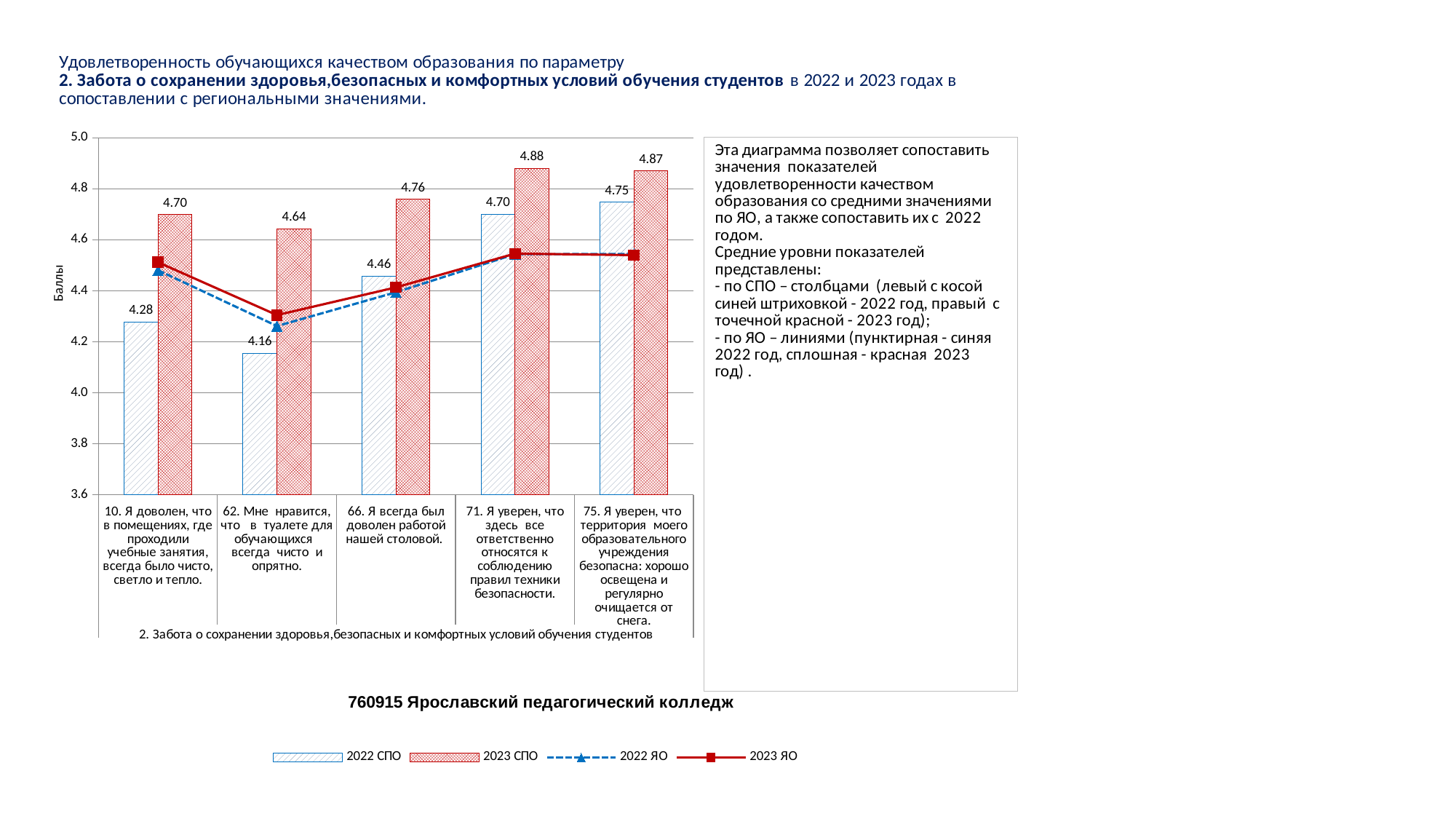
What kind of chart is shown on the slide? Combined bar and line chart What is the 2022 СПО value for category "10. Я доволен, что в помещениях, где проходили учебные занятия, всегда было чисто, светло и тепло."? 4.28 What is the difference between the 2023 СПО and 2022 СПО values for category "62. Мне нравится, что в туалете для обучающихся всегда чисто и опрятно."? 0.48 Which is larger for category "75. Я уверен, что территория моего образовательного учреждения безопасна...": the 2022 СПО value or the 2023 СПО value? 2023 СПО How many categories are shown on the x axis of the chart? 5 What is the label of the vertical axis of the chart? Баллы Is the 2023 ЯО value for category "62. Мне нравится, что в туалете для обучающихся всегда чисто и опрятно." greater or less than 4.4? less What is the 2023 СПО value for category "66. Я всегда был доволен работой нашей столовой."? 4.76 Which category has the highest 2023 СПО value? 71. Я уверен, что здесь все ответственно относятся к соблюдению правил техники безопасности. What is the 2022 СПО value for category "62. Мне нравится, что в туалете для обучающихся всегда чисто и опрятно."? 4.16 Which category has the lowest 2022 СПО value? 62. Мне нравится, что в туалете для обучающихся всегда чисто и опрятно. How many series does the chart legend list? 4